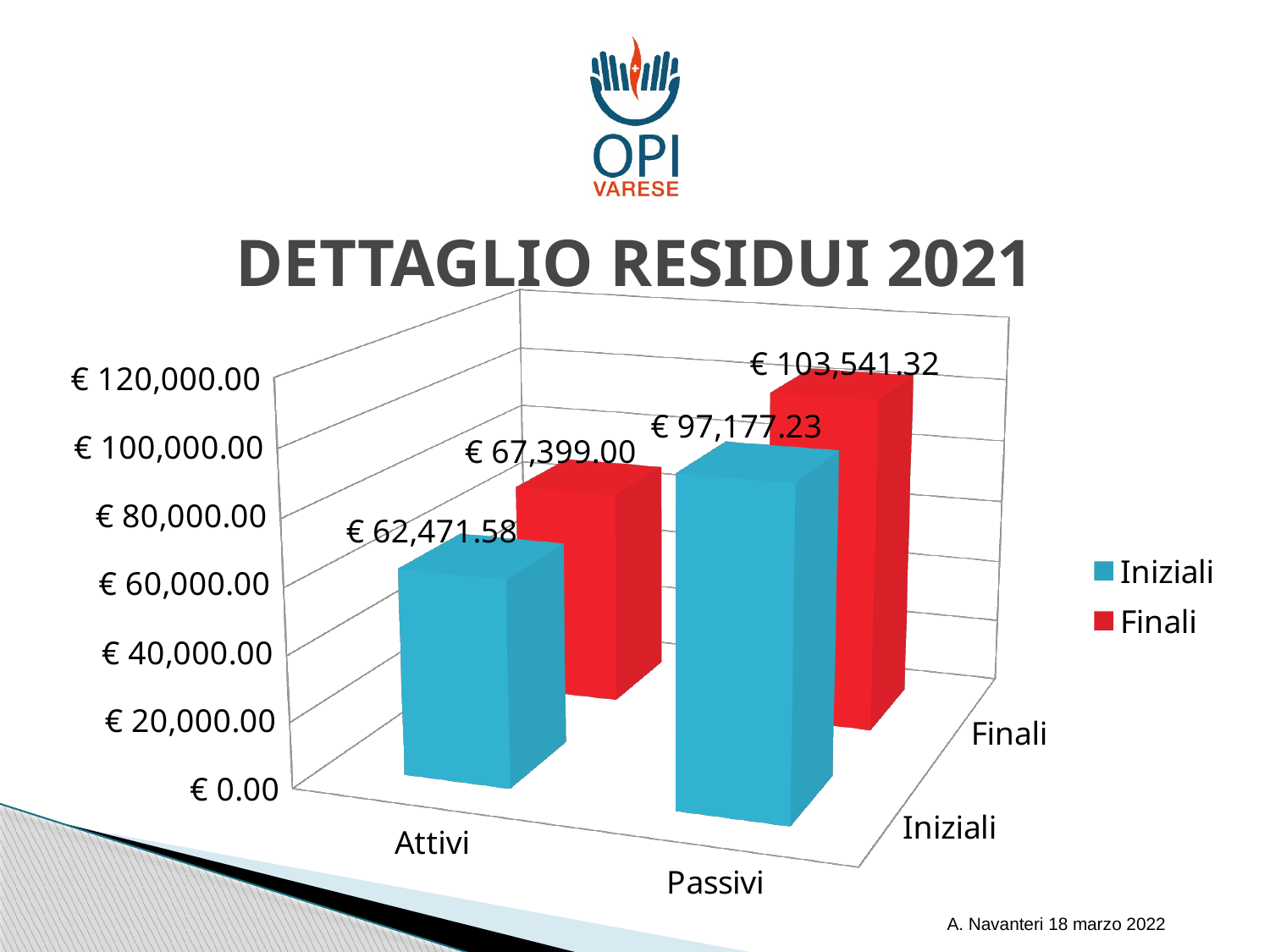
What is the difference between the Finali and Iniziali values for Attivi? € 4,927.42 Which bar has the highest value in the chart? Passivi Finali What is the title of the chart? DETTAGLIO RESIDUI 2021 Which is larger, the Iniziali value for Passivi or the Finali value for Attivi? Iniziali value for Passivi What is the difference between the Finali and Iniziali values for Passivi? € 6,364.09 What type of chart is shown on the slide? Bar chart What is the Iniziali value for Attivi? € 62,471.58 What is the Finali value for Passivi? € 103,541.32 What is the Iniziali value for Passivi? € 97,177.23 Which bar has the lowest value in the chart? Attivi Iniziali How many series does the legend list? 2 What is the Finali value for Attivi? € 67,399.00